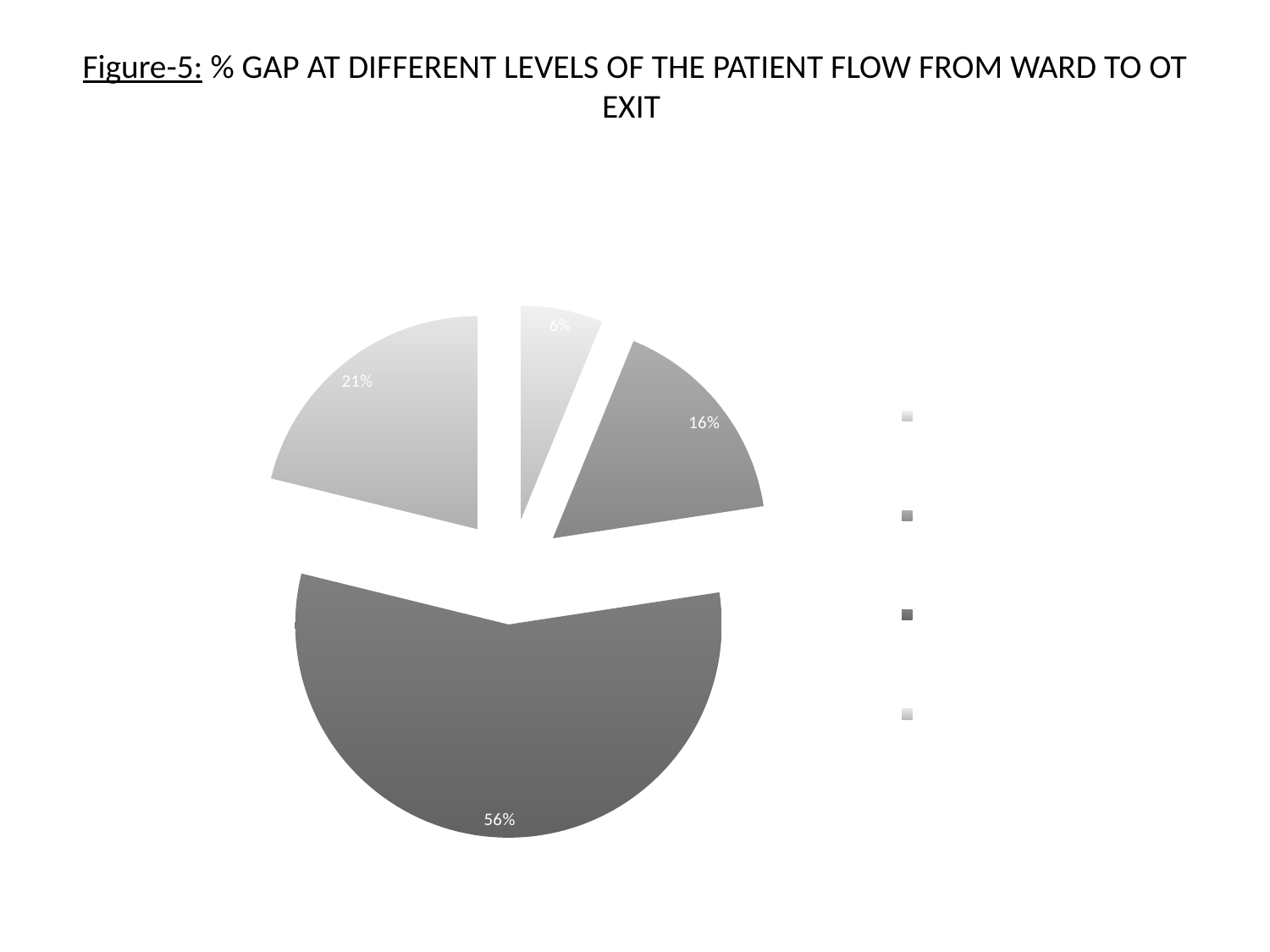
What is the percentage shown on the largest slice of the pie chart? 56% What is the percentage shown on the smallest slice of the pie chart? 6% What is the difference between the 21% slice and the 16% slice in the pie chart? 5% How many slices does the pie chart have? 4 What percentage is shown on the darkest slice at the bottom of the pie chart? 56% Which is larger in the pie chart: the slice at the upper left or the slice at the upper right? the slice at the upper left (21%) What percentage is shown on the slice at the upper right of the pie chart? 16% What kind of chart is shown on the slide? pie chart What is the difference between the largest slice (56%) and the second-largest slice (21%) in the pie chart? 35% What is the figure number given in the slide title? Figure-5 What percentage is shown on the light grey slice at the upper left of the pie chart? 21% How many entries does the legend of the pie chart list? 4